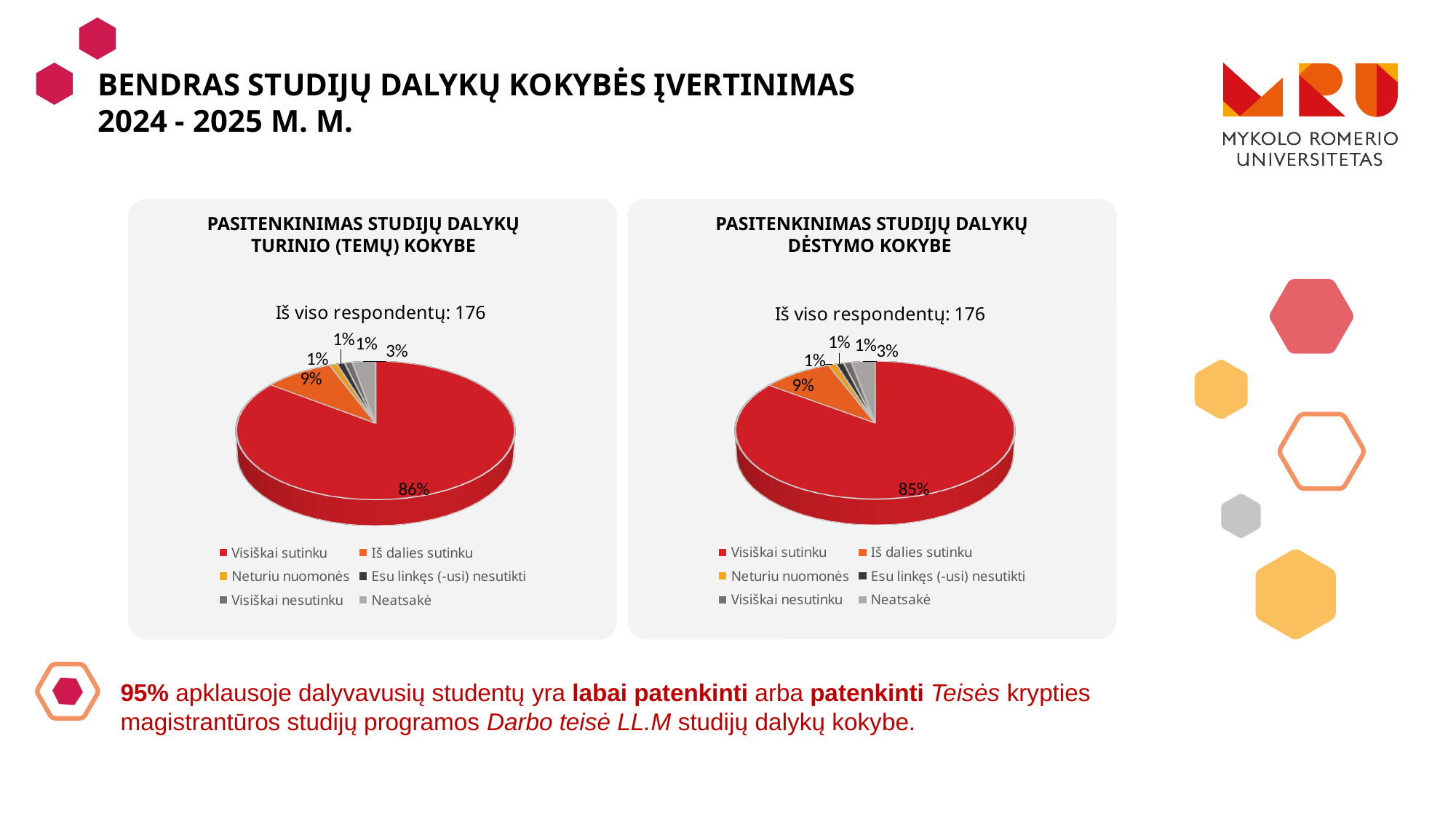
In the right chart (Pasitenkinimas studijų dalykų dėstymo kokybe), what percentage is shown for Visiškai sutinku? 85% In the left chart (Pasitenkinimas studijų dalykų turinio (temų) kokybe), which category has the largest share? Visiškai sutinku In the right chart (Pasitenkinimas studijų dalykų dėstymo kokybe), what colour is the Visiškai sutinku slice? Red How many categories does the legend of the left chart (Pasitenkinimas studijų dalykų turinio (temų) kokybe) list? 6 In the right chart (Pasitenkinimas studijų dalykų dėstymo kokybe), which category has the largest share? Visiškai sutinku In the left chart (Pasitenkinimas studijų dalykų turinio (temų) kokybe), what percentage is shown for Visiškai sutinku? 86% In the left chart (Pasitenkinimas studijų dalykų turinio (temų) kokybe), what is the difference between the Visiškai sutinku and Iš dalies sutinku shares? 77% Which chart shows a larger share for Visiškai sutinku, the left one (turinio kokybe) or the right one (dėstymo kokybe)? The left one (turinio kokybe) How many respondents are reported for the left chart (Pasitenkinimas studijų dalykų turinio (temų) kokybe)? 176 In the left chart (Pasitenkinimas studijų dalykų turinio (temų) kokybe), what percentage is shown for Iš dalies sutinku? 9% In the right chart (Pasitenkinimas studijų dalykų dėstymo kokybe), what percentage is shown for Neatsakė? 3% What type of chart is used in the right chart (Pasitenkinimas studijų dalykų dėstymo kokybe)? Pie chart